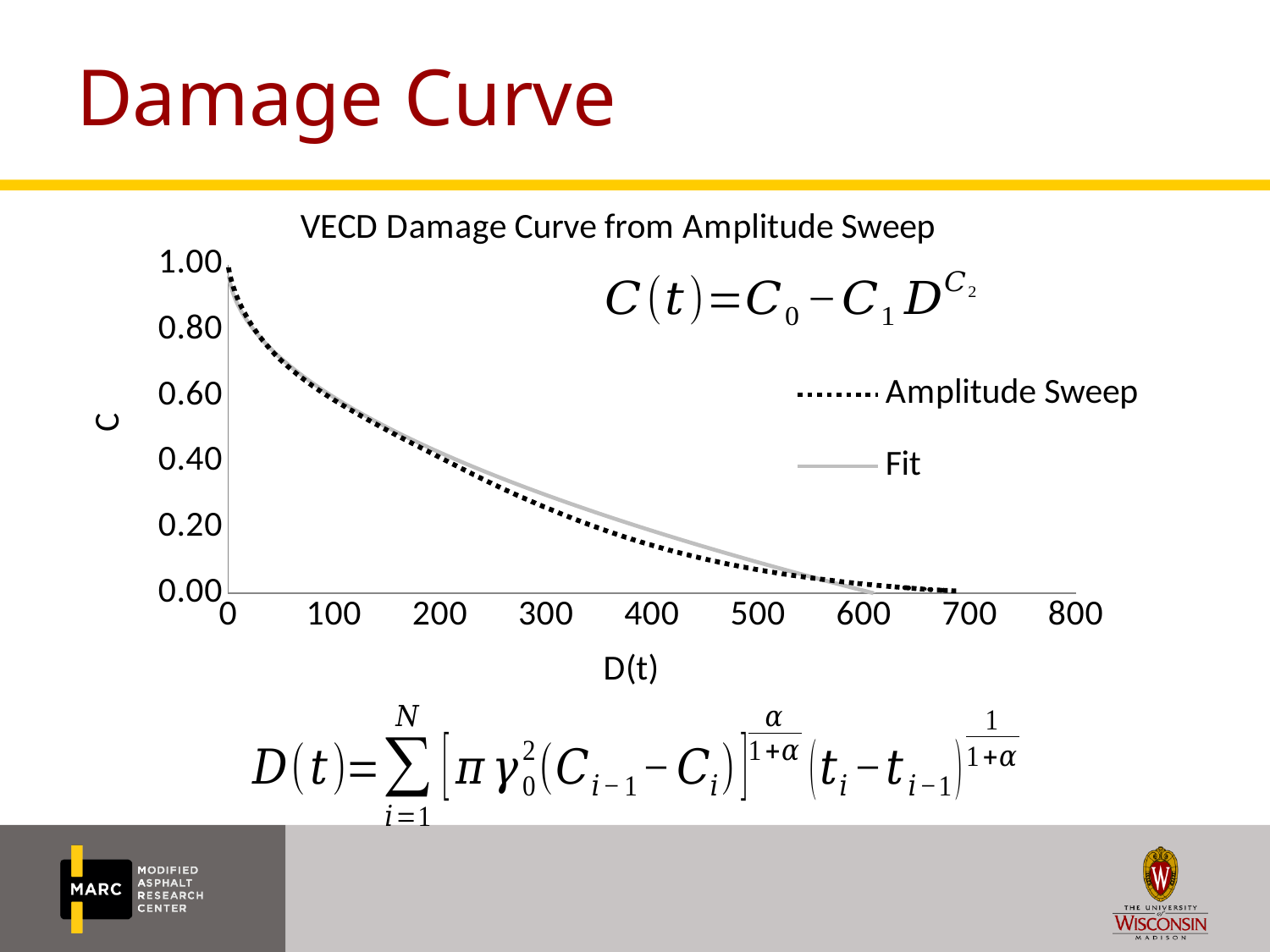
What are the two series named in the legend? Amplitude Sweep and Fit Is the value of C for the Amplitude Sweep series at D(t) = 500 greater or less than 0.20? less Is the value of C for the Amplitude Sweep series at D(t) = 100 greater or less than 0.40? greater What is the title of the chart? VECD Damage Curve from Amplitude Sweep What kind of chart is shown on the slide? line chart Is the value of C for the Fit series at D(t) = 300 greater or less than 0.60? less Which series extends further along the D(t) axis before reaching C = 0.00, Amplitude Sweep or Fit? Amplitude Sweep Do the values of C rise or fall as D(t) increases? fall How many series does the legend list? 2 At D(t) = 400, which series has the higher value of C, Amplitude Sweep or Fit? Fit What is the maximum value shown on the D(t) axis? 800